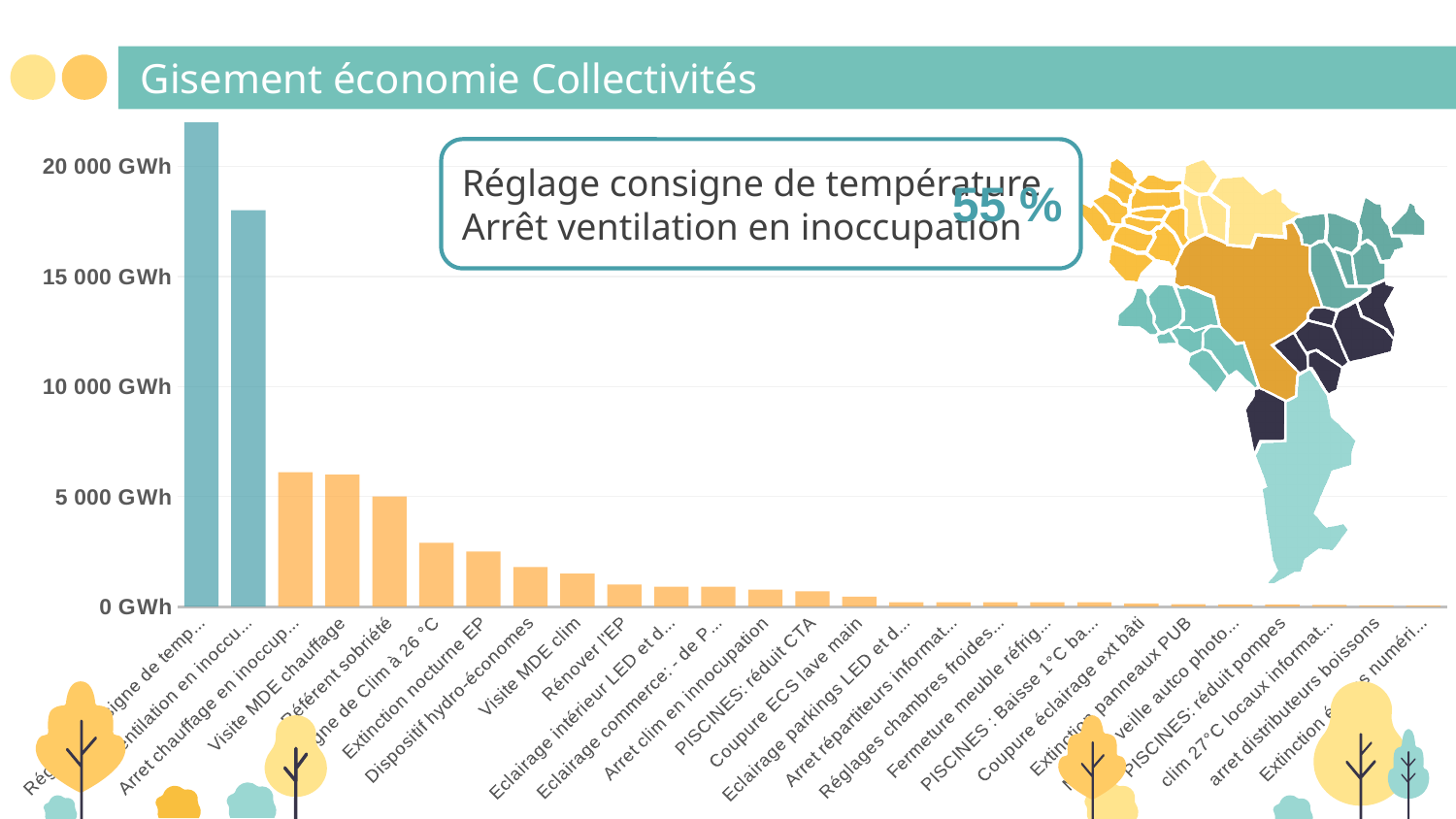
What percentage is shown in the callout box for Réglage consigne de température and Arrêt ventilation en inoccupation? 55 % What kind of chart is shown on the slide? bar chart Do the bar values generally rise or fall from left to right along the x axis? fall Which category has the highest value in the chart? Réglage consigne de température Which is larger, the value for Référent sobriété or the value for Rénover l'EP? Référent sobriété What is the title of the slide containing the chart? Gisement économie Collectivités Is the value for the first bar (Réglage consigne de température) greater or less than 20 000 GWh? greater Is the value for Visite MDE chauffage greater or less than 5 000 GWh? greater Which is larger, the value for Visite MDE chauffage or the value for Extinction nocturne EP? Visite MDE chauffage Is the value for Arrêt ventilation en inoccupation greater or less than 15 000 GWh? greater